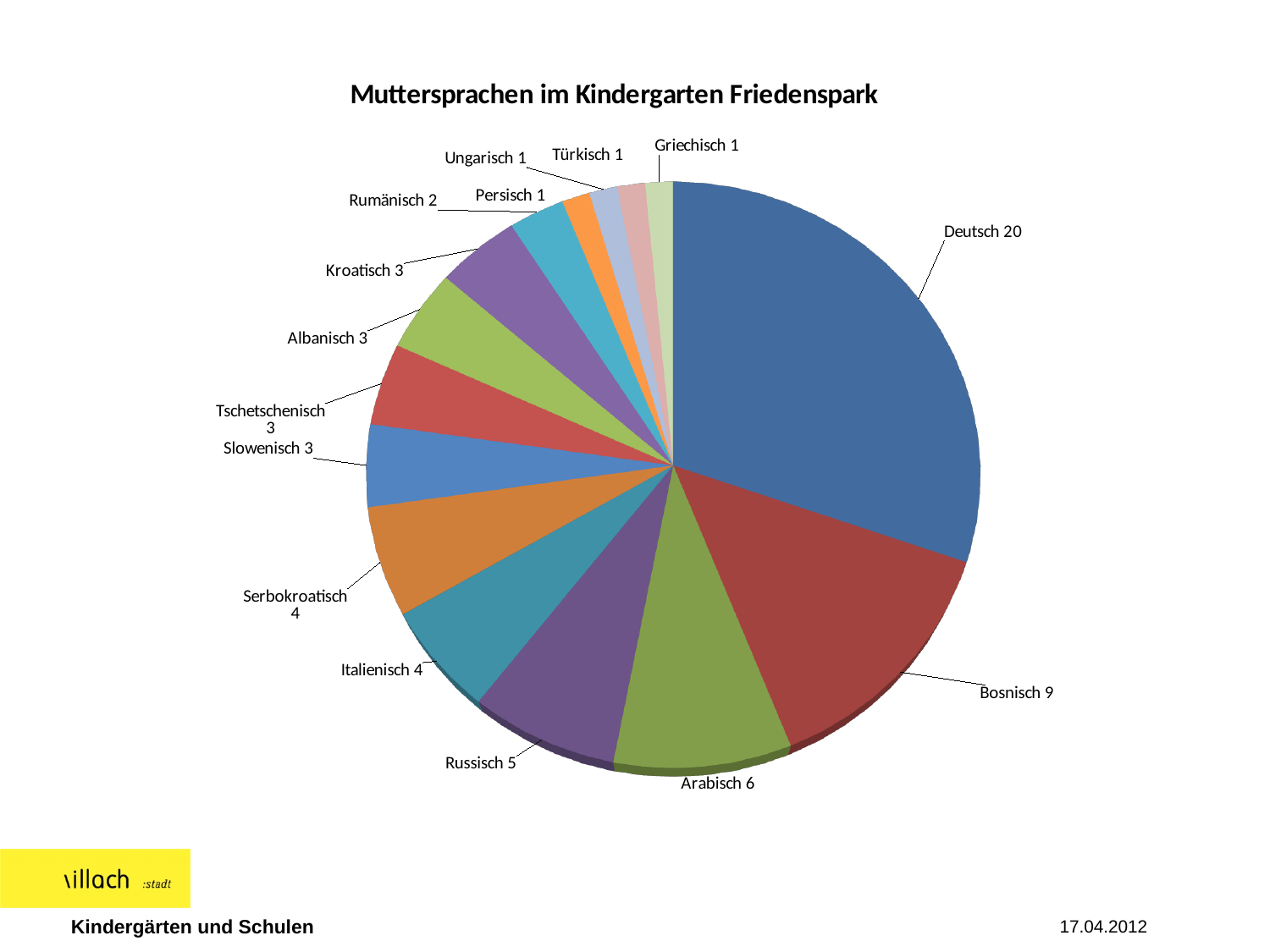
What kind of chart is shown on the slide? pie chart How many languages (slices) are shown in the pie chart? 15 What is the value shown for Arabisch? 6 Which is larger, the value for Arabisch or the value for Russisch? Arabisch Which language has the largest slice of the pie? Deutsch What is the value shown for Rumänisch? 2 What is the difference between the values for Deutsch and Bosnisch? 11 How many children have Deutsch as their mother tongue according to the chart? 20 What is the value shown for Russisch? 5 What is the value shown for Bosnisch? 9 What is the title of the chart? Muttersprachen im Kindergarten Friedenspark What is the total of all values shown in the pie chart? 66